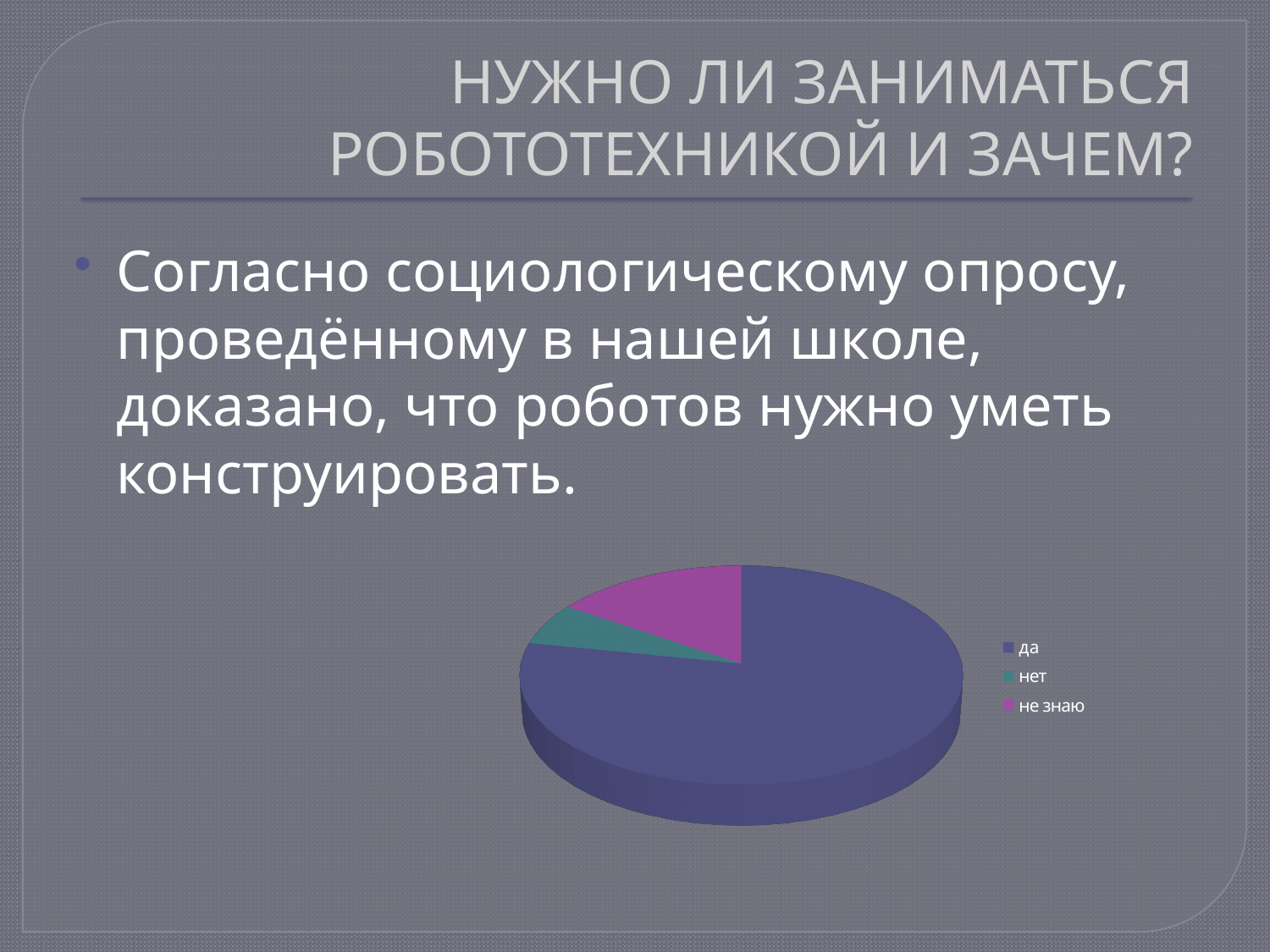
What are the legend entries of the pie chart, in order? да, нет, не знаю How many entries does the legend of the pie chart list? 3 Which slice is larger in the pie chart, "нет" or "не знаю"? не знаю What colour is the "не знаю" slice in the pie chart? magenta (purple-pink) Which slice is larger in the pie chart, "да" or "не знаю"? да Which category has the largest slice in the pie chart? да What kind of chart is shown on the slide? pie chart Does the "да" slice take up more or less than half of the pie chart? more How many slices does the pie chart have? 3 Which category has the smallest slice in the pie chart? нет